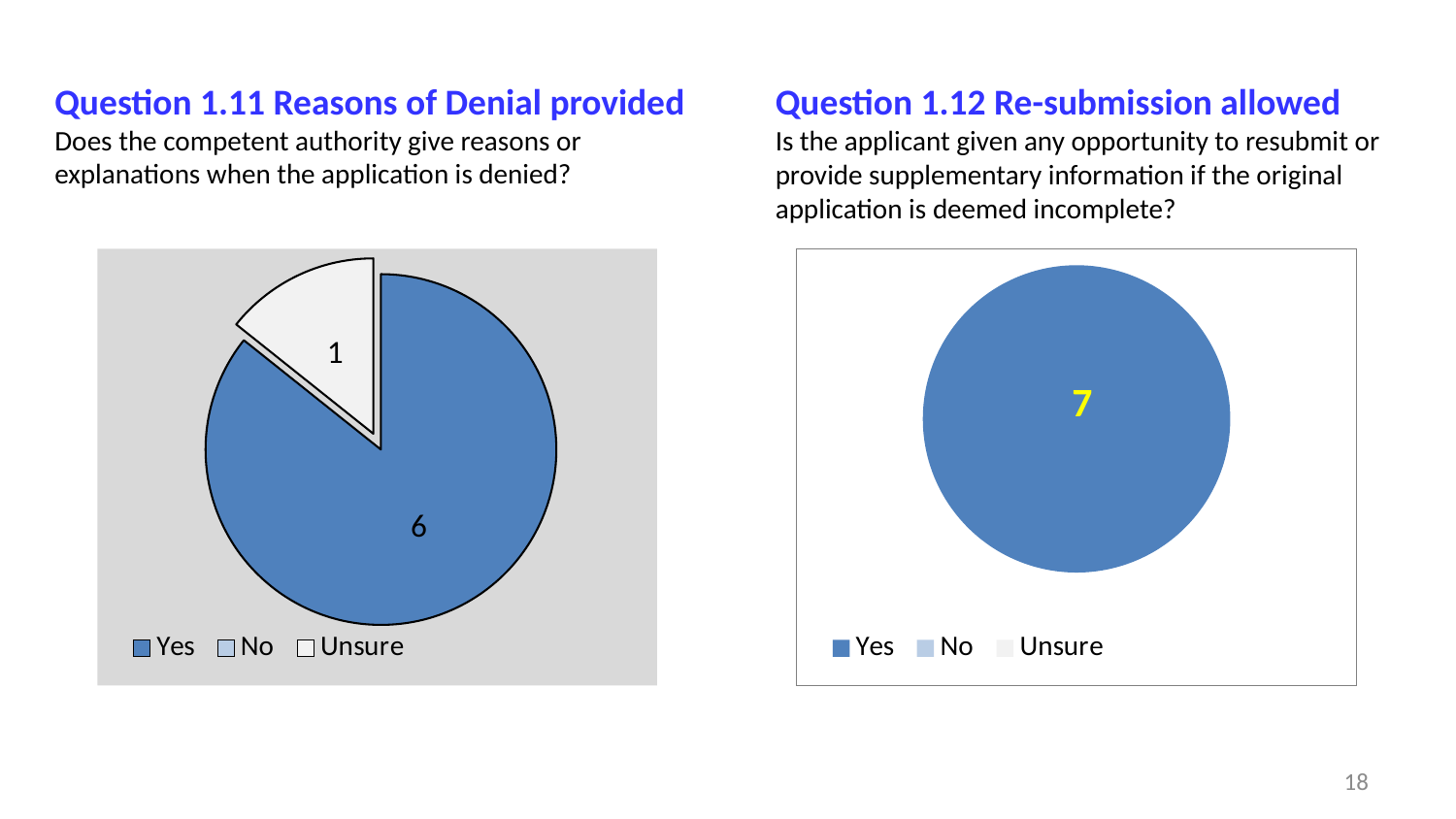
In the Question 1.11 Reasons of Denial provided chart, what value is shown for Unsure? 1 In the Question 1.12 Re-submission allowed chart, what value is shown for Yes? 7 In the Question 1.11 Reasons of Denial provided chart, which category has the largest slice? Yes In the Question 1.11 Reasons of Denial provided chart, what is the difference between the Yes value and the Unsure value? 5 In the Question 1.11 Reasons of Denial provided chart, which is larger, Yes or Unsure? Yes In the Question 1.12 Re-submission allowed chart, which category does the entire pie represent? Yes In the Question 1.11 Reasons of Denial provided chart, what is the total of all slices? 7 In the Question 1.11 Reasons of Denial provided chart, what value is shown for Yes? 6 How many entries does the legend of the Question 1.11 Reasons of Denial provided chart list? 3 In the Question 1.12 Re-submission allowed chart, how many slices are visible in the pie? 1 What type of chart is used on the left side of the slide for Question 1.11? Pie chart What is the title of the chart on the right side of the slide? Question 1.12 Re-submission allowed